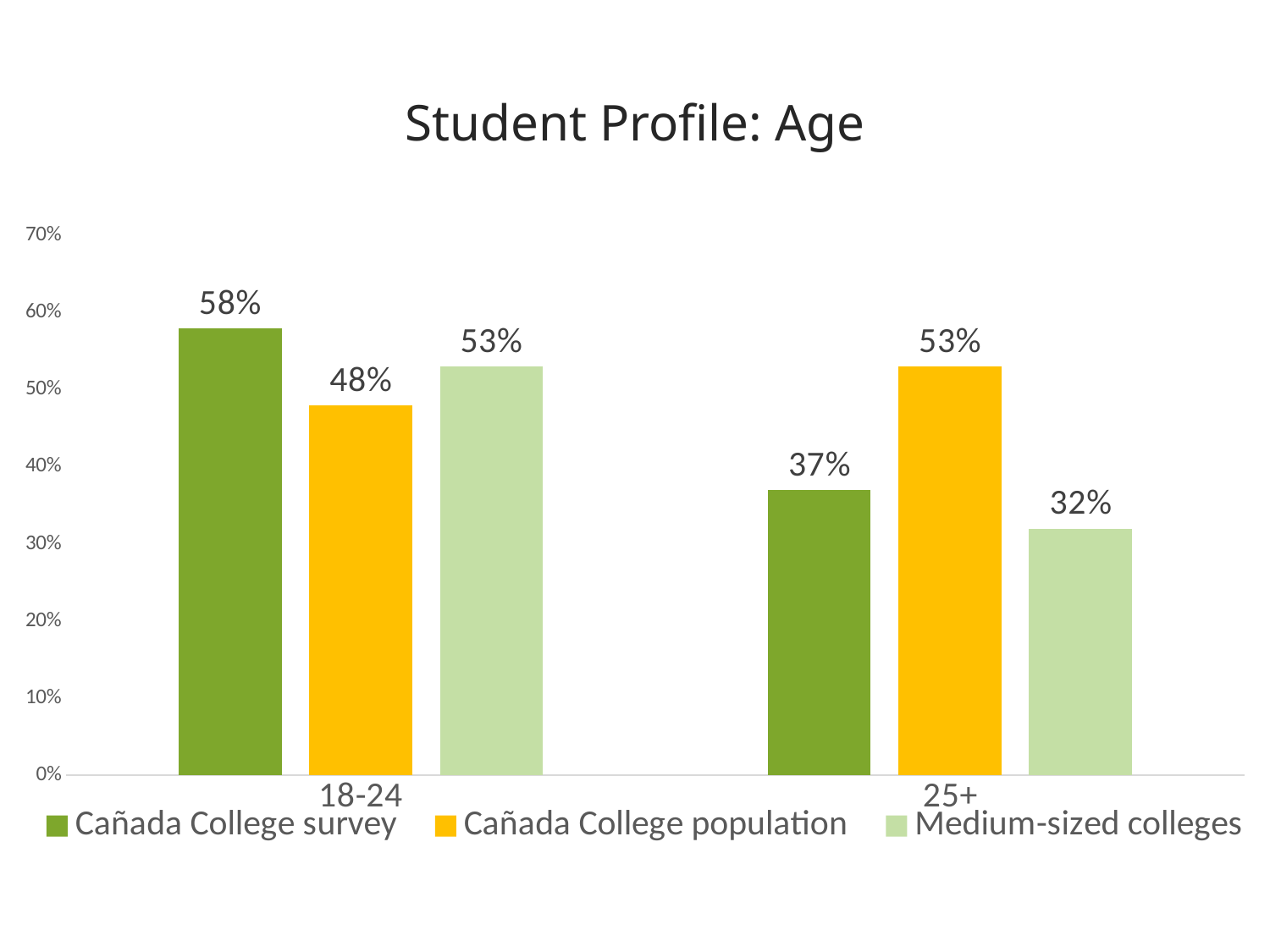
How many series does the legend list? 3 Which is larger: Cañada College population for 18-24 or Medium-sized colleges for 18-24? Medium-sized colleges for 18-24 What is the value for Medium-sized colleges in the 25+ category? 32% What is the value for Cañada College population in the 25+ category? 53% How many age categories are shown on the x axis? 2 What is the difference between the Cañada College survey values for 18-24 and 25+? 21% Which series has the highest value in the 18-24 category? Cañada College survey What is the title of the chart? Student Profile: Age What is the value for Cañada College survey in the 18-24 category? 58% Which series has the lowest value in the 25+ category? Medium-sized colleges What is the value for Cañada College population in the 18-24 category? 48% What kind of chart is shown on the slide? Bar chart